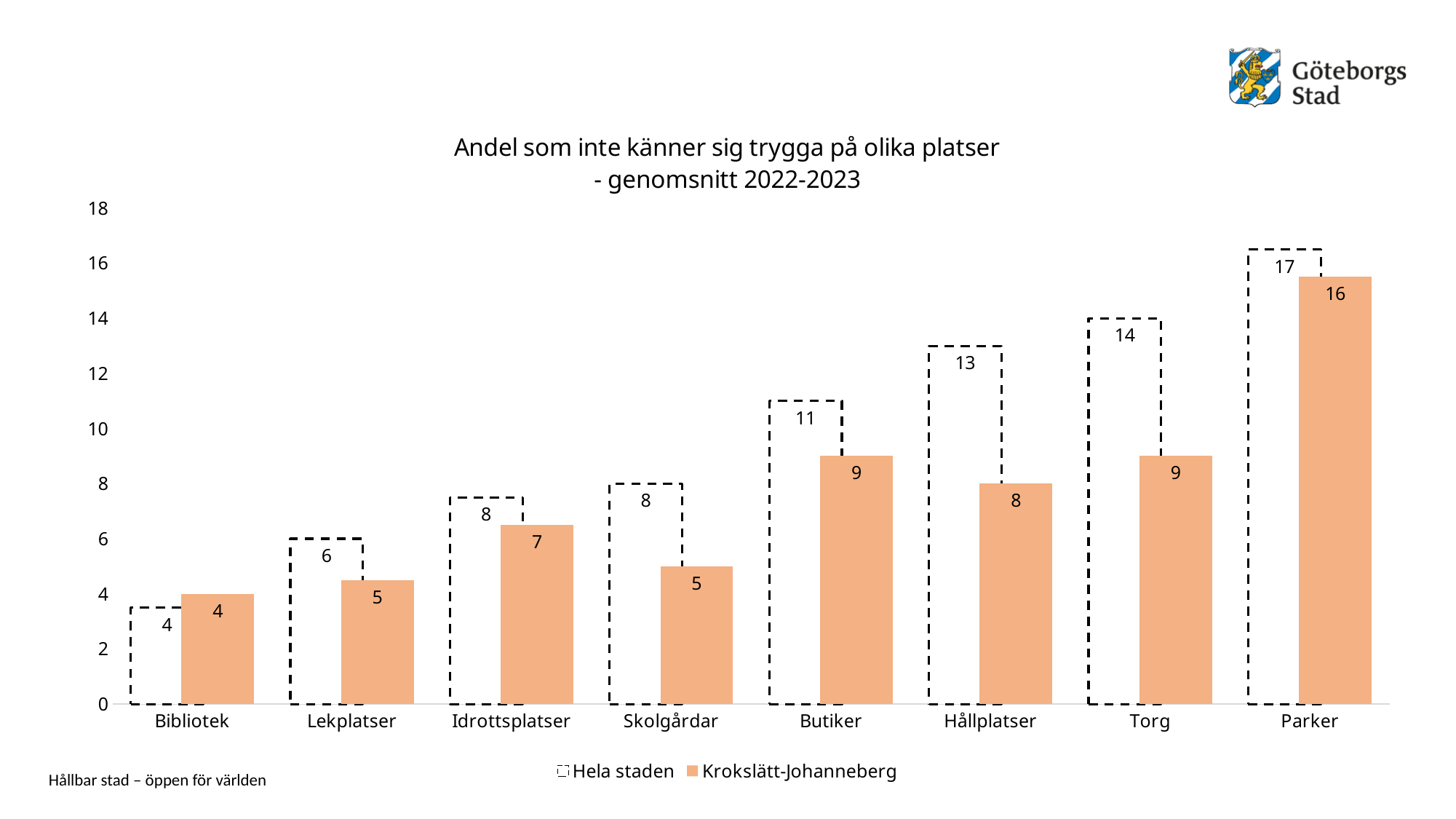
Do the Hela staden values rise or fall from Bibliotek to Parker along the x axis? Rise How many categories are shown on the x axis? 8 What kind of chart is shown on the slide? Bar chart How many series does the legend list? 2 Which category has the lowest value in the Hela staden series? Bibliotek What is the value for Hållplatser in the Hela staden series? 13 Is the Krokslätt-Johanneberg value for Parker greater or less than 14? greater What is the value for Parker in the Hela staden series? 17 What is the difference between the Hela staden and Krokslätt-Johanneberg values for Hållplatser? 5 For Torg, which series has the larger value, Hela staden or Krokslätt-Johanneberg? Hela staden Which category has the highest value in the Krokslätt-Johanneberg series? Parker What is the value for Butiker in the Krokslätt-Johanneberg series? 9